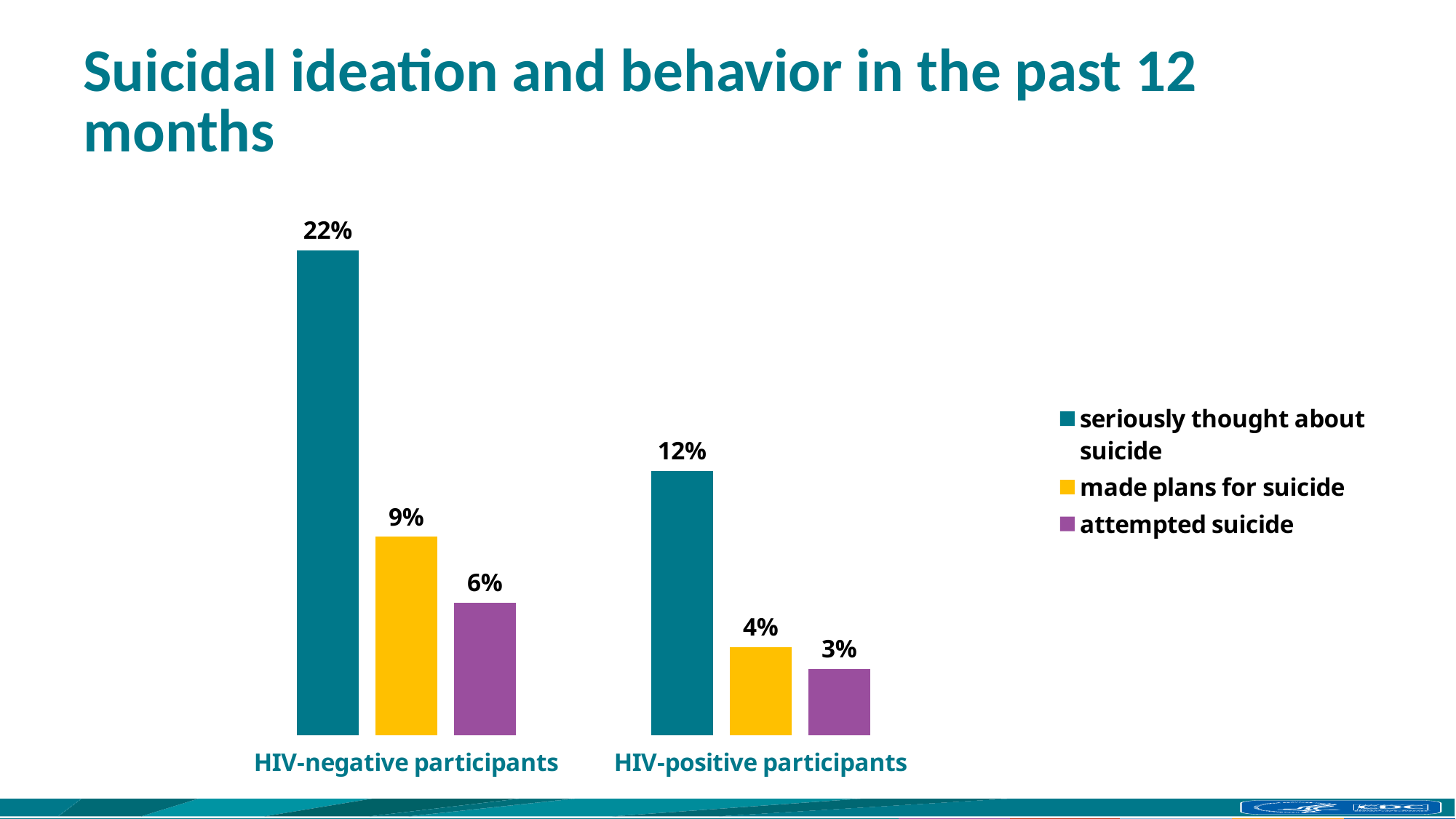
Which group has the highest value for seriously thought about suicide? HIV-negative participants How many participant groups are shown on the x axis? 2 What is the difference between the percentage of HIV-negative and HIV-positive participants who seriously thought about suicide? 10% What is the difference between made plans for suicide and attempted suicide among HIV-negative participants? 3% How many series does the legend list? 3 What percentage of HIV-positive participants attempted suicide? 3% What percentage of HIV-positive participants made plans for suicide? 4% What kind of chart is shown on the slide? bar chart What percentage of HIV-negative participants seriously thought about suicide? 22% What percentage of HIV-negative participants attempted suicide? 6% Which bar shows the lowest value on the chart? attempted suicide, HIV-positive participants Which is larger: made plans for suicide among HIV-negative participants or seriously thought about suicide among HIV-positive participants? seriously thought about suicide among HIV-positive participants